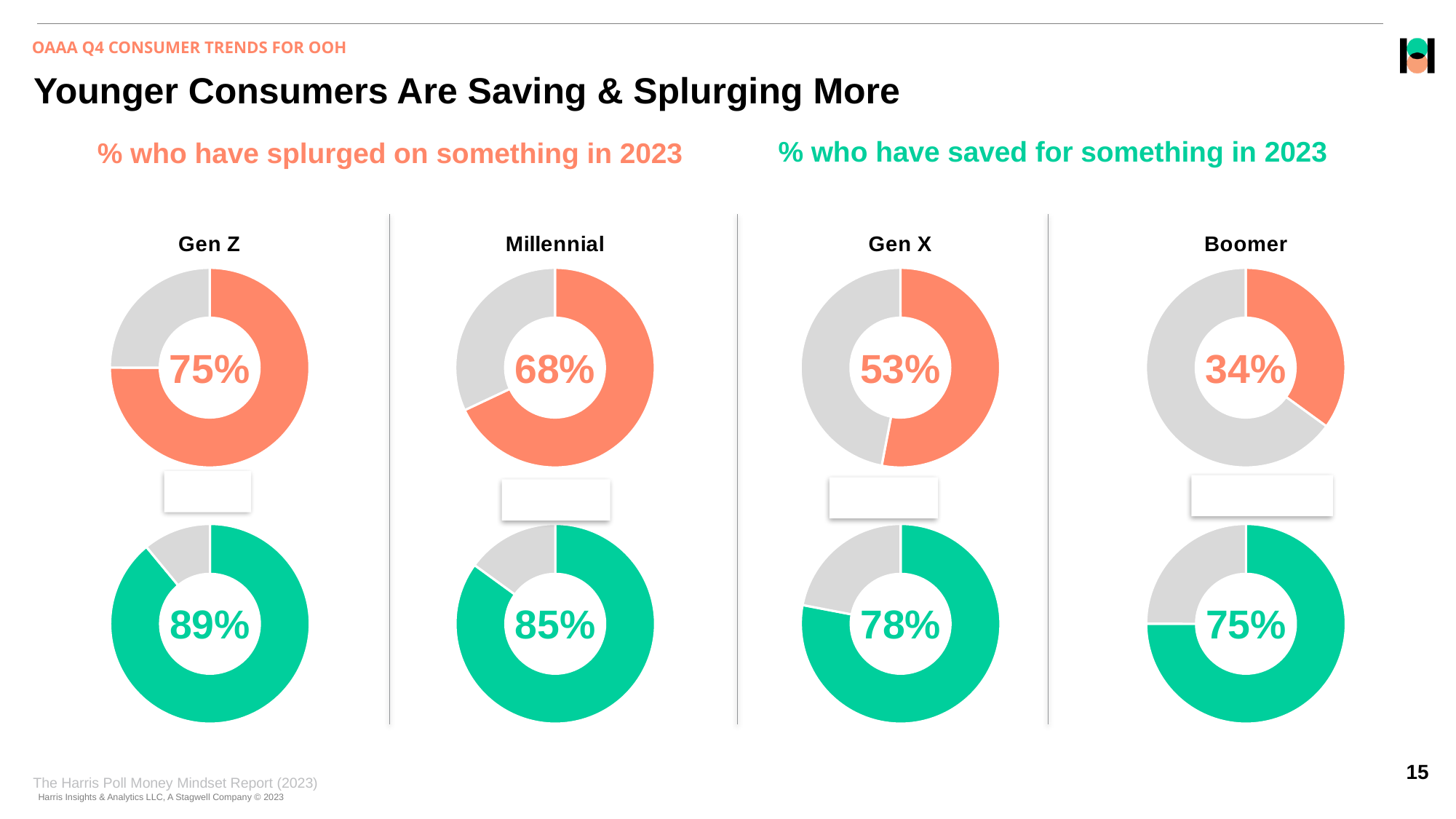
What percentage of Gen Z have splurged on something in 2023? 75% Which is larger: the percentage of Millennials who have saved for something or the percentage of Millennials who have splurged on something in 2023? Saved (85%) Which generation has the highest percentage who have saved for something in 2023? Gen Z What kind of chart is used to show the percentages on this slide? Donut (pie) chart What percentage of Millennials have splurged on something in 2023? 68% How many generations are shown on the slide? 4 What colour represents the percentage who have saved for something in 2023? Green What percentage of Boomers have saved for something in 2023? 75% Do the percentages who have splurged on something in 2023 rise or fall from Gen Z to Boomer? Fall What is the difference between the percentage of Gen Z and Boomers who have splurged on something in 2023? 41 percentage points What percentage of Gen X have saved for something in 2023? 78% Which generation has the lowest percentage who have splurged on something in 2023? Boomer